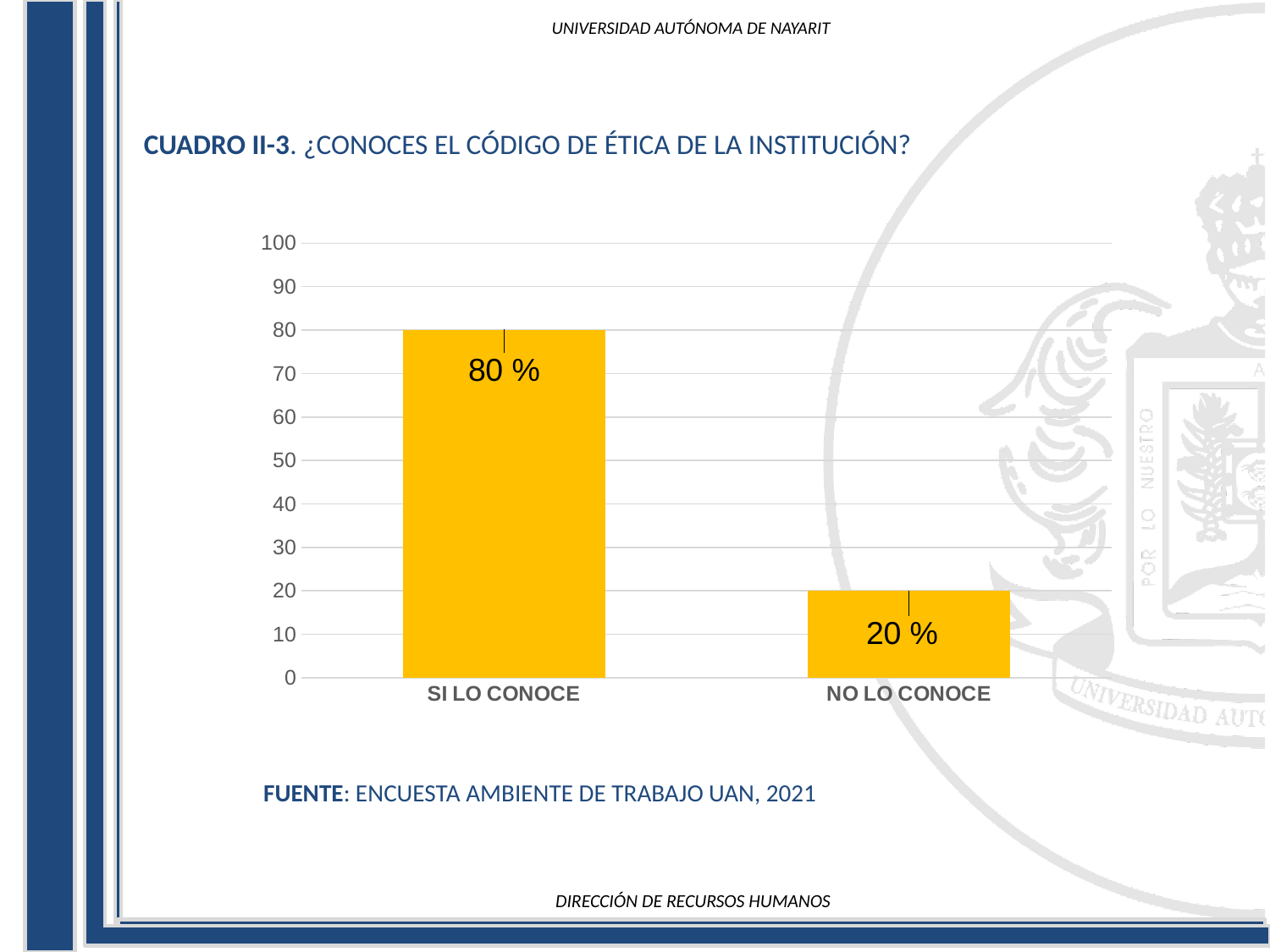
Which is larger, the value for SI LO CONOCE or NO LO CONOCE? SI LO CONOCE Is the value for NO LO CONOCE greater or less than 30? less What kind of chart is shown on the slide? bar chart How many categories are shown on the x axis? 2 Which category has the highest value? SI LO CONOCE Which category has the lowest value? NO LO CONOCE What colour are the bars in the chart? yellow What is the difference between the values for SI LO CONOCE and NO LO CONOCE? 60 % What is the value for NO LO CONOCE? 20 % What is the value for SI LO CONOCE? 80 % What is the maximum value shown on the y axis? 100 Is the value for SI LO CONOCE greater or less than 50? greater